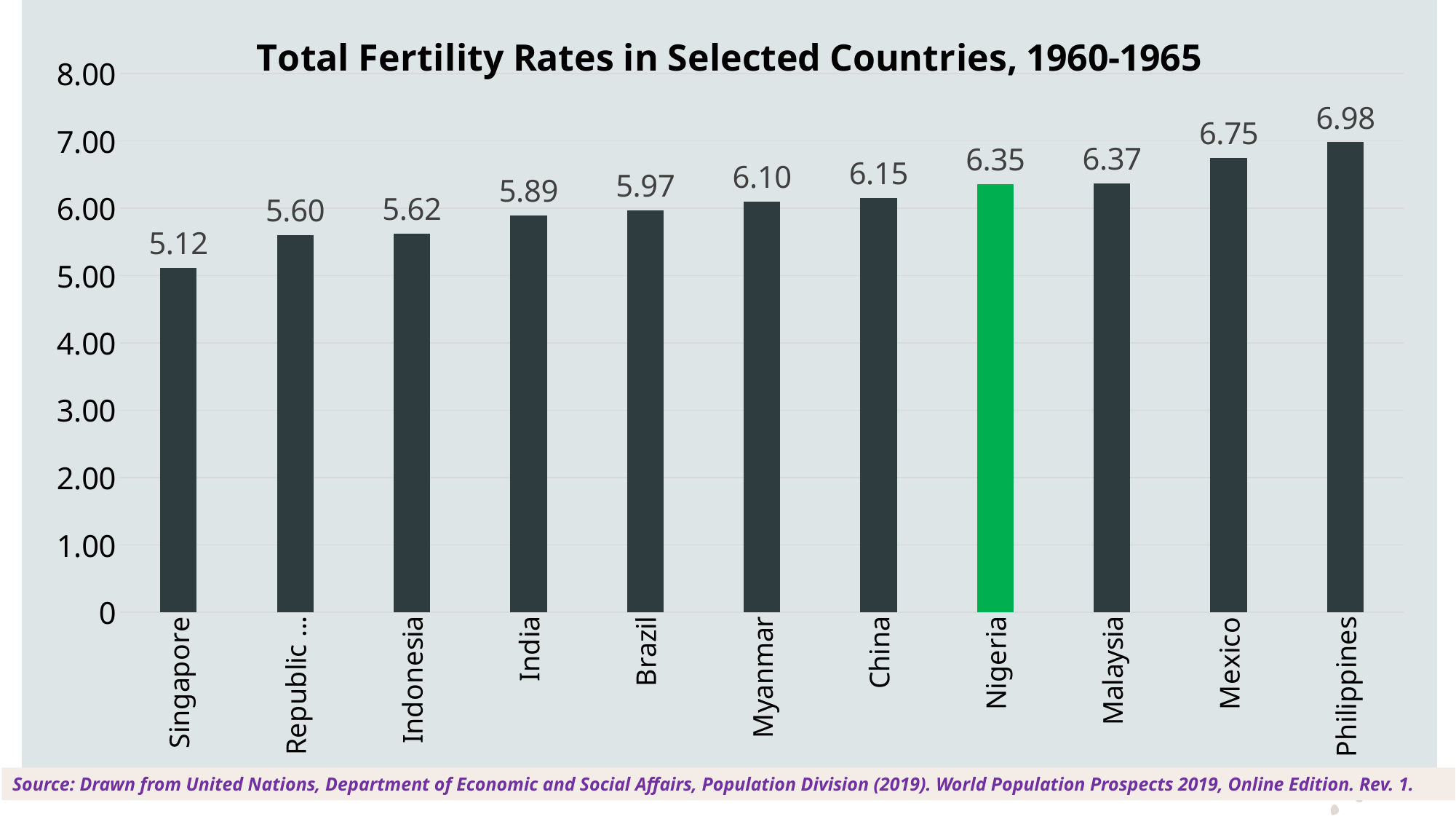
What is the total fertility rate shown for Nigeria? 6.35 What is the difference between the fertility rates of the Philippines and Singapore? 1.86 Which country has the lowest total fertility rate on the chart? Singapore What is the difference between the fertility rates of Mexico and China? 0.60 Which has a higher fertility rate, India or Brazil? Brazil Which country's bar is highlighted in green? Nigeria What is the total fertility rate shown for Mexico? 6.75 What is the total fertility rate shown for Singapore? 5.12 Which country has the highest total fertility rate on the chart? Philippines How many countries are shown on the chart? 11 What kind of chart is shown on the slide? Bar chart Is the value for Myanmar greater or less than 6.00? greater